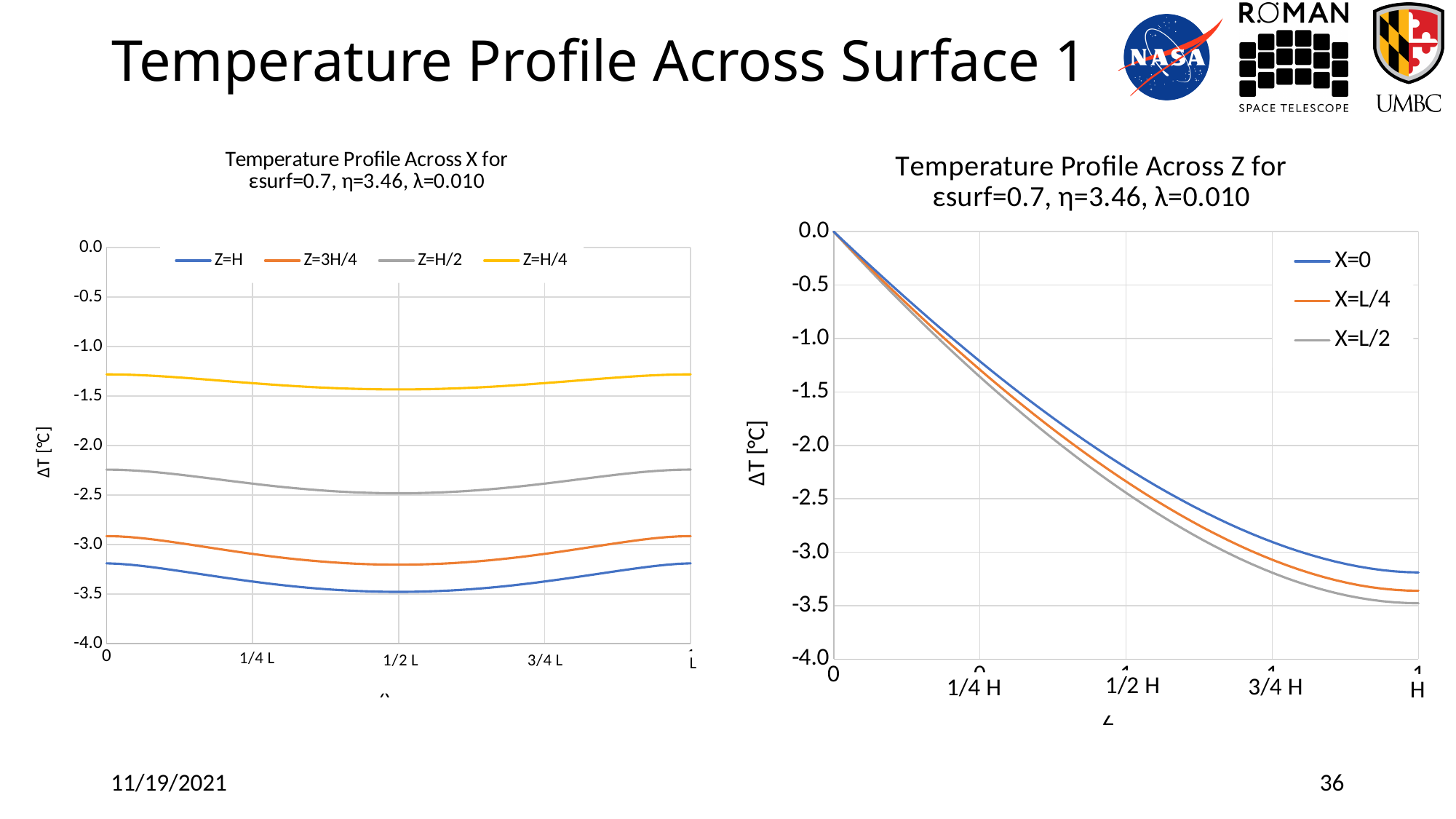
In the right chart, 'Temperature Profile Across Z', which series has the lowest value at H? X=L/2 How many series does the legend of the left chart, 'Temperature Profile Across X', list? 4 In the left chart, 'Temperature Profile Across X', is the value for Z=H/4 at 1/2 L greater or less than -2.0? greater In the right chart, 'Temperature Profile Across Z', do the values for X=0 rise or fall as Z increases from 0 to H? fall In the right chart, 'Temperature Profile Across Z', which is larger at 3/4 H: the value for X=0 or the value for X=L/2? X=0 In the left chart, 'Temperature Profile Across X', is the value for Z=H at 1/2 L greater or less than -3.0? less In the right chart, 'Temperature Profile Across Z', is the value for X=L/2 at H greater or less than -3.0? less In the left chart, 'Temperature Profile Across X', which series has the lowest ΔT values? Z=H How many series does the legend of the right chart, 'Temperature Profile Across Z', list? 3 What kind of chart is the left chart, 'Temperature Profile Across X'? line chart In the left chart, 'Temperature Profile Across X', which series has the highest ΔT values? Z=H/4